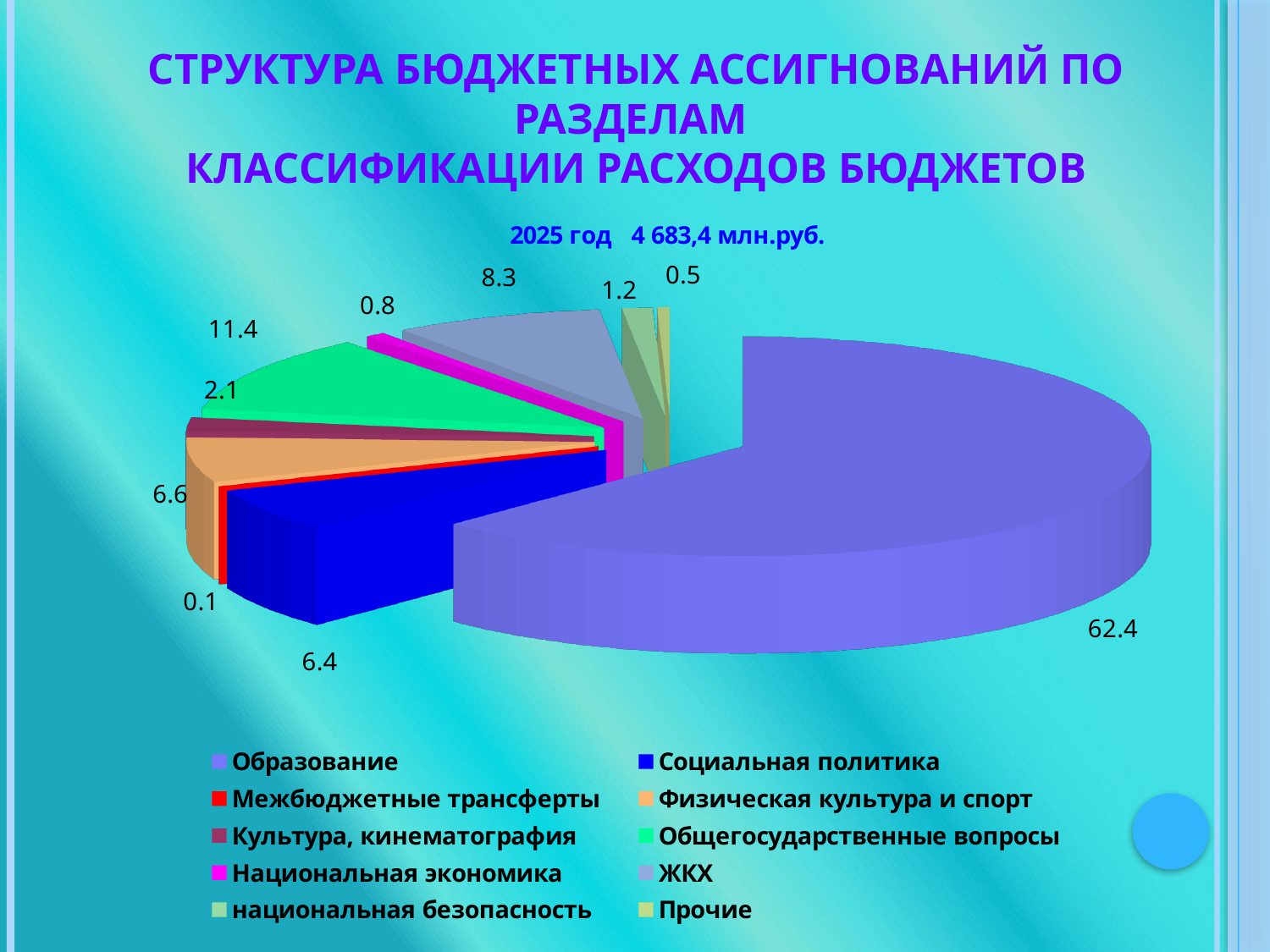
Which is larger, the value for Физическая культура и спорт or the value for Социальная политика? Физическая культура и спорт What is the value shown for Образование? 62.4 Which category has the largest slice of the pie? Образование What is the value shown for Общегосударственные вопросы? 11.4 Which category has the smallest slice of the pie? Межбюджетные трансферты What is the value shown for ЖКХ? 8.3 How many categories does the legend list? 10 What is the difference between the values for Общегосударственные вопросы and ЖКХ? 3.1 What is the value shown for Социальная политика? 6.4 What total amount for 2025 is stated above the chart? 4 683,4 млн.руб. What is the value shown for Межбюджетные трансферты? 0.1 What kind of chart is shown on the slide? pie chart